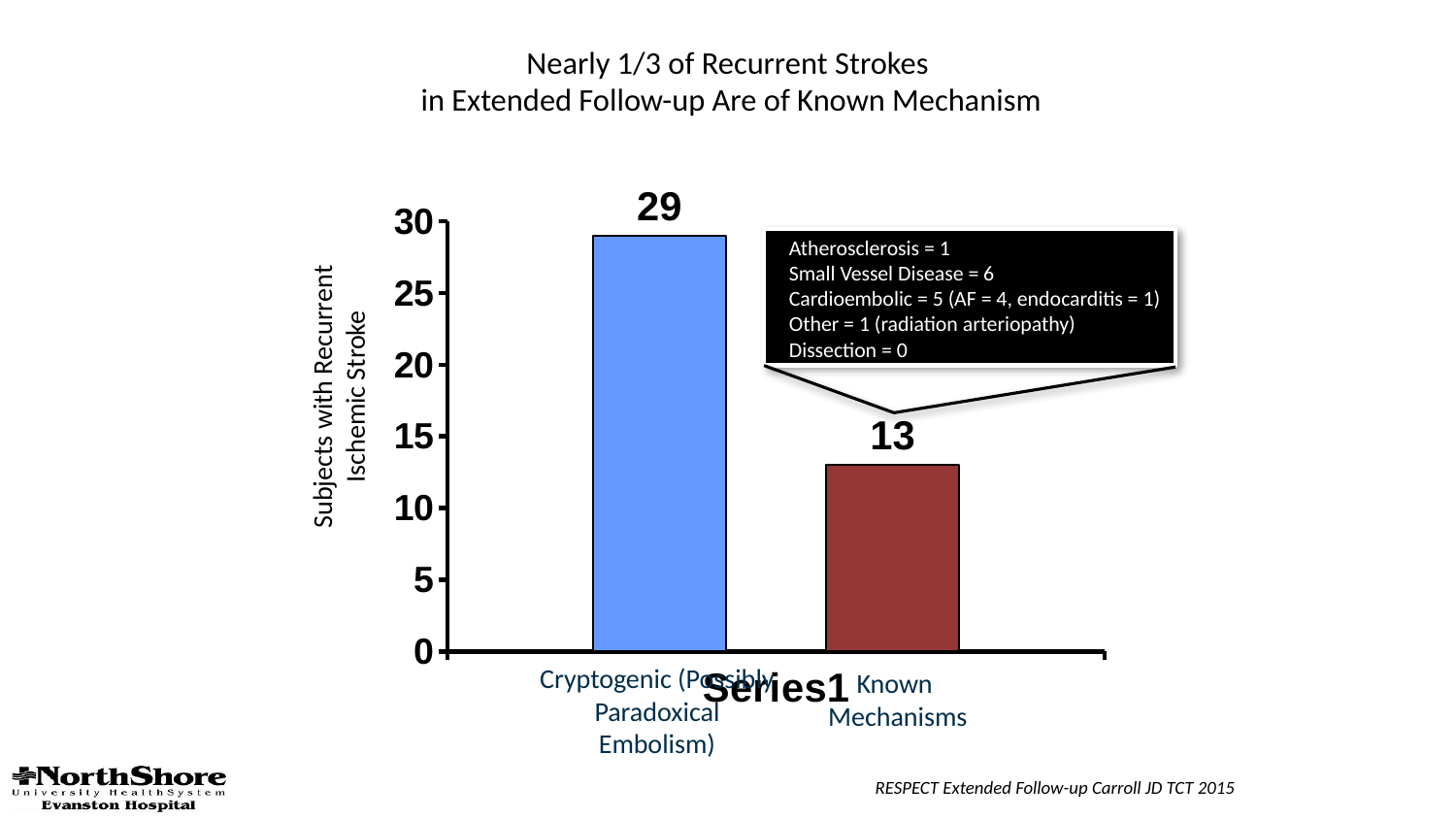
Is the value for Known Mechanisms greater or less than 15? less Is the value for Cryptogenic (Possibly Paradoxical Embolism) greater or less than 25? greater How many categories are shown on the x axis? 2 Which category has the highest value? Cryptogenic (Possibly Paradoxical Embolism) What is the value for Cryptogenic (Possibly Paradoxical Embolism)? 29 Which is larger, the value for Cryptogenic (Possibly Paradoxical Embolism) or the value for Known Mechanisms? Cryptogenic (Possibly Paradoxical Embolism) What is the value for Known Mechanisms? 13 What kind of chart is shown on the slide? Bar chart What is the label of the y axis? Subjects with Recurrent Ischemic Stroke According to the callout box, how many Known Mechanism strokes were due to Small Vessel Disease? 6 What is the difference between the Cryptogenic (Possibly Paradoxical Embolism) value and the Known Mechanisms value? 16 Which category has the lowest value? Known Mechanisms